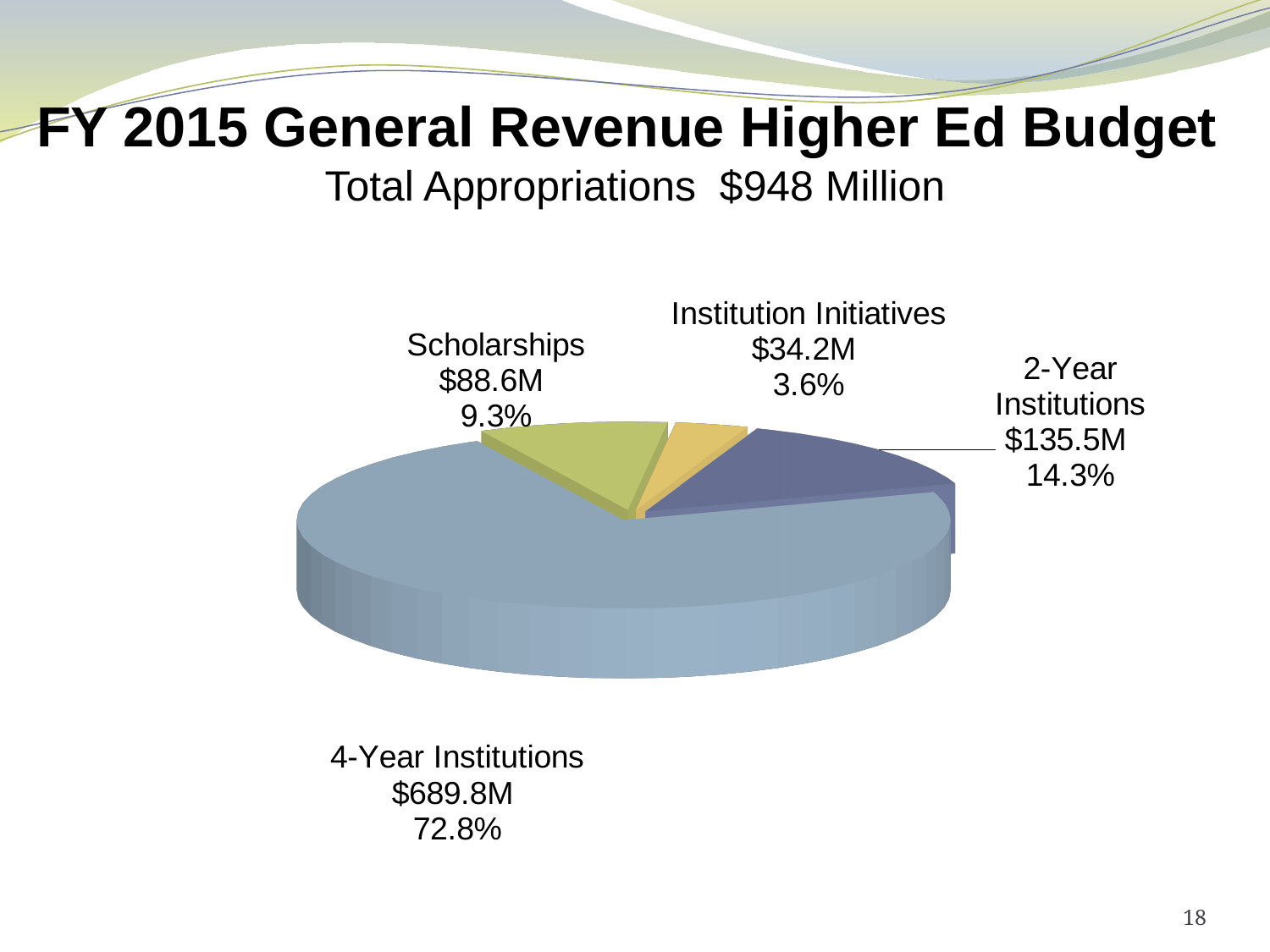
What is the dollar amount for Scholarships? $88.6M Which is larger, the amount for Scholarships or the amount for 2-Year Institutions? 2-Year Institutions What total appropriations amount is stated in the chart's subtitle? $948 Million How many slices does the pie chart have? 4 What is the dollar amount for Institution Initiatives? $34.2M What kind of chart is shown on the slide? Pie chart What share of the pie does Scholarships represent? 9.3% Which category has the smallest slice of the pie? Institution Initiatives Which category has the largest slice of the pie? 4-Year Institutions What is the dollar amount for 4-Year Institutions? $689.8M What is the dollar amount for 2-Year Institutions? $135.5M What share of the pie does 2-Year Institutions represent? 14.3%